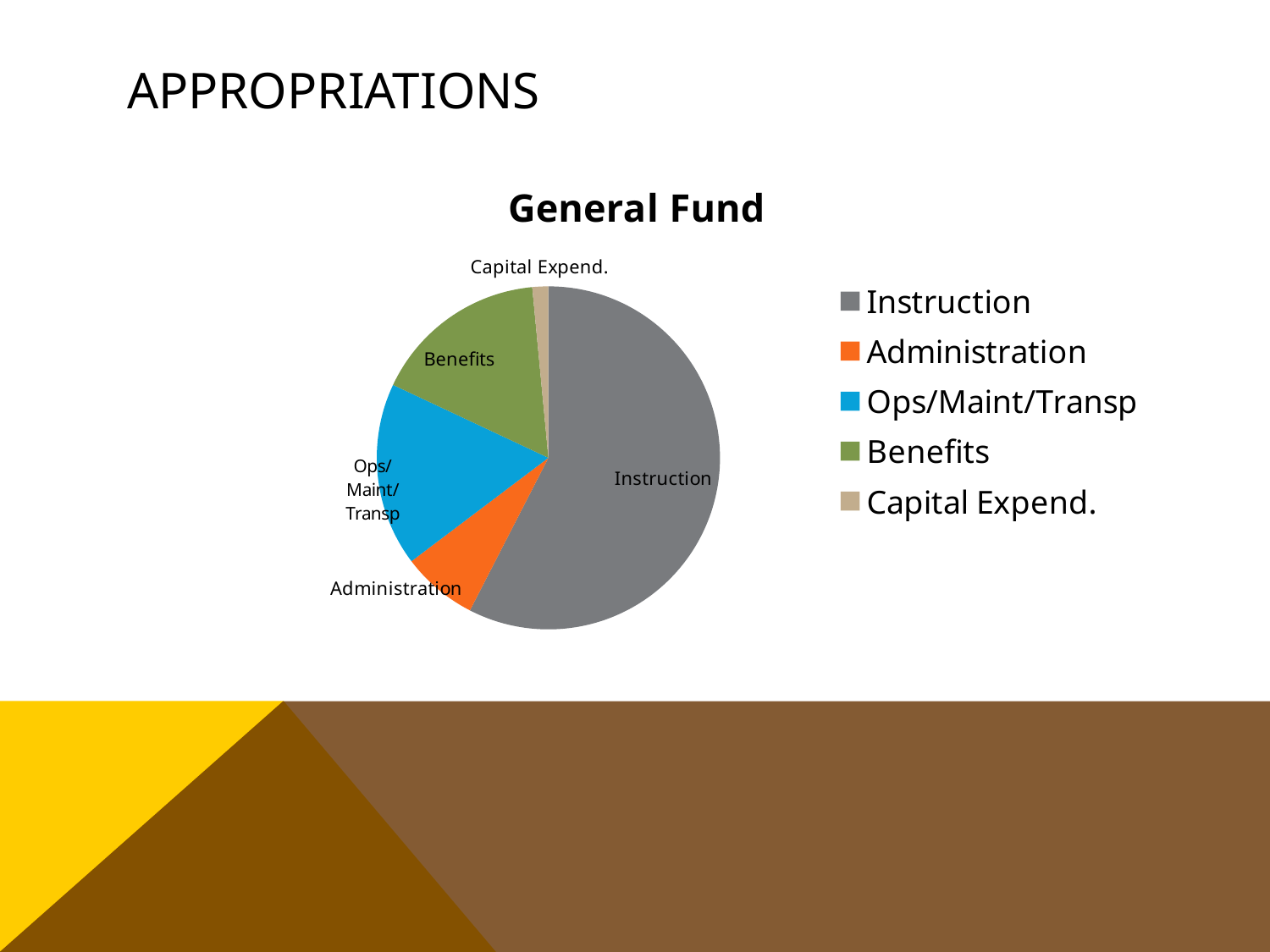
Which slice is larger, Benefits or Capital Expend.? Benefits How many slices does the General Fund pie chart have? 5 What kind of chart is shown on the slide? pie chart Which slice is larger, Administration or Benefits? Benefits Which slice is larger, Ops/Maint/Transp or Administration? Ops/Maint/Transp Which category has the smallest slice of the General Fund pie? Capital Expend. What is the title of the chart? General Fund How many entries does the legend list? 5 Which category has the largest slice of the General Fund pie? Instruction What colour is the Administration slice in the pie chart? orange